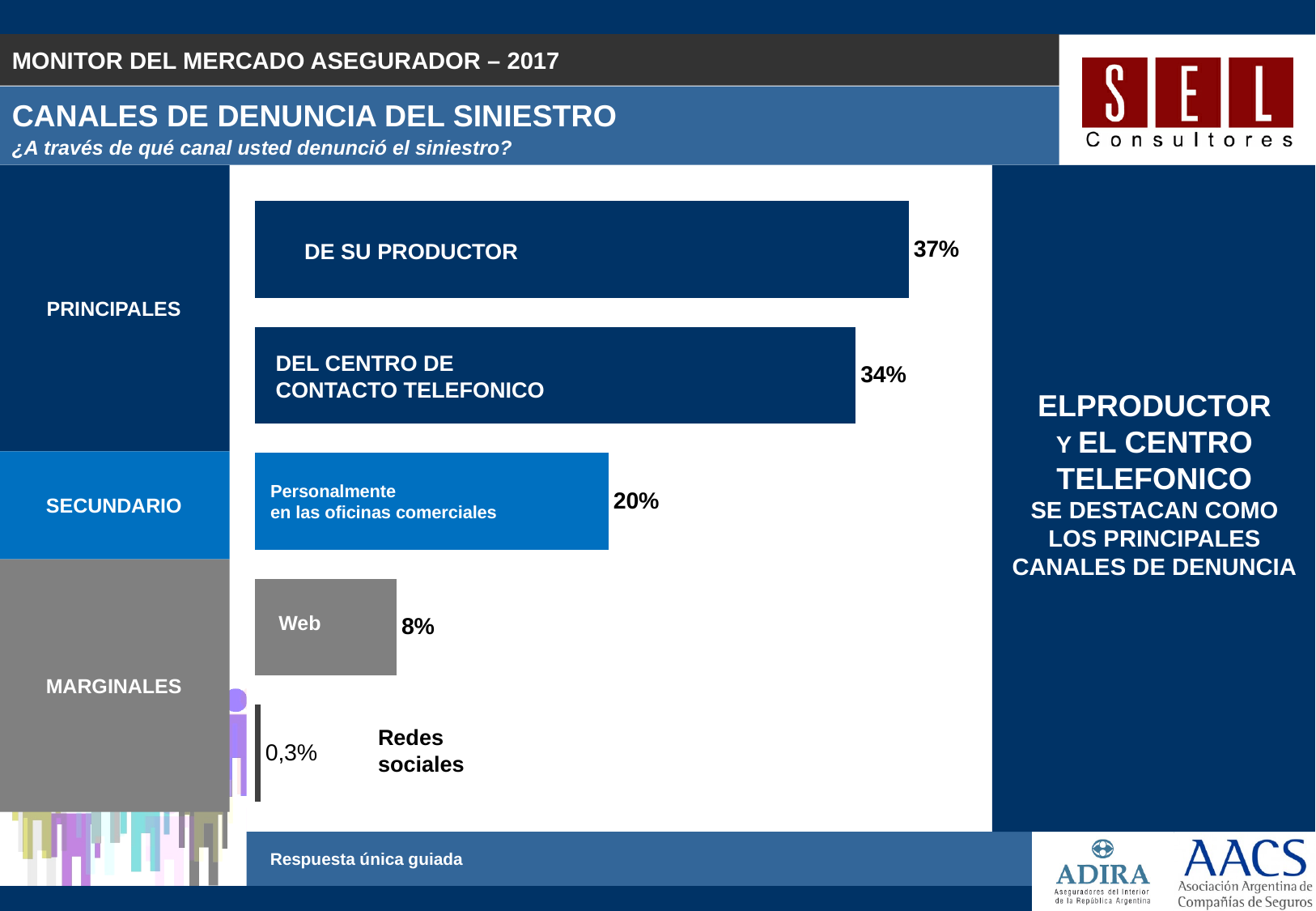
What percentage is shown for 'Redes sociales'? 0,3% Which channel has the highest percentage? DE SU PRODUCTOR What is the value shown for 'DEL CENTRO DE CONTACTO TELEFONICO'? 34% Which channel is classified as 'SECUNDARIO'? Personalmente en las oficinas comerciales Which channel has the lowest percentage? Redes sociales What percentage is shown for 'Personalmente en las oficinas comerciales'? 20% What is the value shown for 'Web'? 8% What percentage of respondents reported the claim through 'DE SU PRODUCTOR'? 37% How many channels are shown in the chart? 5 What kind of chart is used on the slide? Bar chart Which is larger, the value for 'Personalmente en las oficinas comerciales' or the value for 'Web'? Personalmente en las oficinas comerciales What is the difference in percentage points between 'DE SU PRODUCTOR' and 'DEL CENTRO DE CONTACTO TELEFONICO'? 3 percentage points